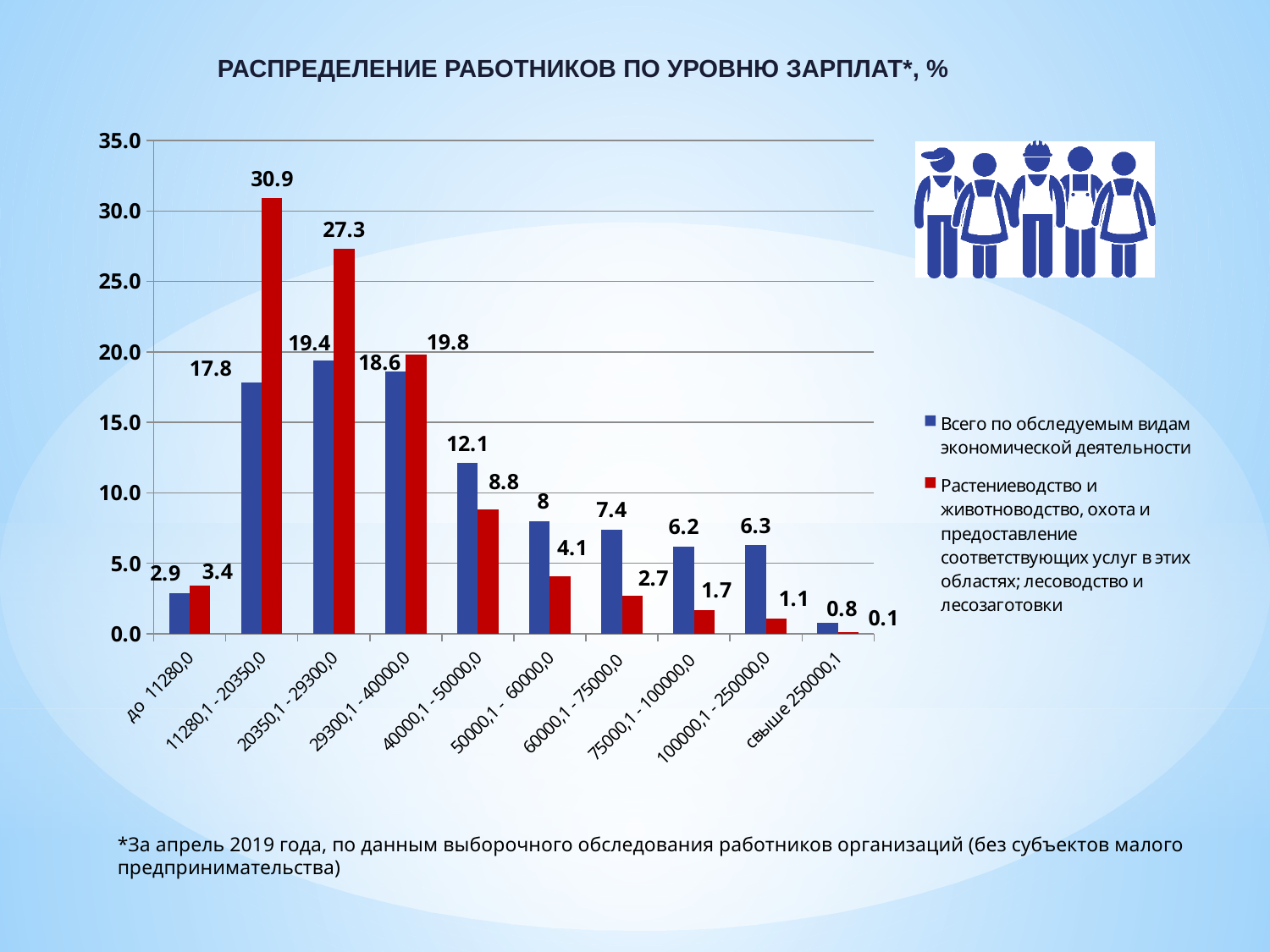
What is the difference between the two series for the category '11280,1 - 20350,0'? 13.1 Which salary category has the lowest value in the series 'Растениеводство и животноводство, охота и предоставление соответствующих услуг в этих областях; лесоводство и лесозаготовки'? свыше 250000,1 Is the value for '20350,1 - 29300,0' in the series 'Растениеводство и животноводство, охота и предоставление соответствующих услуг в этих областях; лесоводство и лесозаготовки' greater or less than 25.0? greater Which salary category has the highest value in the series 'Всего по обследуемым видам экономической деятельности'? 20350,1 - 29300,0 What is the value for the category '40000,1 - 50000,0' in the series 'Всего по обследуемым видам экономической деятельности'? 12.1 How many salary categories are shown on the x axis? 10 For the category '60000,1 - 75000,0', which series has the larger value? Всего по обследуемым видам экономической деятельности What type of chart is shown on the slide? bar chart What is the value for the category '11280,1 - 20350,0' in the series 'Растениеводство и животноводство, охота и предоставление соответствующих услуг в этих областях; лесоводство и лесозаготовки'? 30.9 How many series does the legend list? 2 From the category '29300,1 - 40000,0' onward, do the values of the series 'Растениеводство и животноводство, охота и предоставление соответствующих услуг в этих областях; лесоводство и лесозаготовки' rise or fall along the x axis? fall What colour are the bars for the series 'Всего по обследуемым видам экономической деятельности'? blue